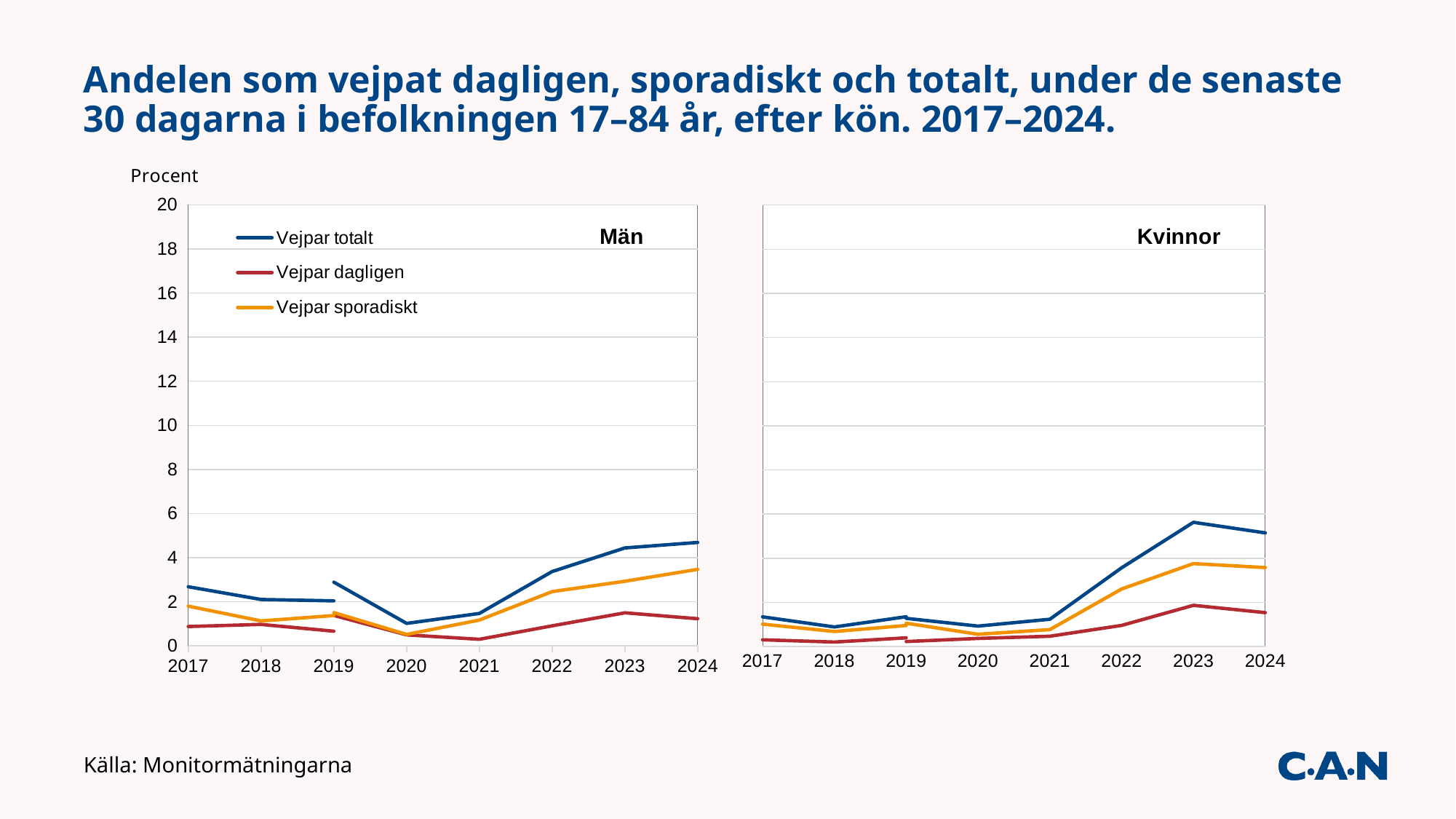
In the Kvinnor chart, is the value for Vejpar totalt in 2023 greater or less than 6? less How many series does the legend on the Män chart list? 3 Which is larger in 2023: Vejpar totalt in the Kvinnor chart or Vejpar totalt in the Män chart? Kvinnor What kind of chart is the Män chart? line chart In the Kvinnor chart, does Vejpar totalt rise or fall from 2021 to 2023? rise In the Män chart, is the value for Vejpar dagligen in 2023 greater or less than 2? less In the Män chart, is the value for Vejpar totalt in 2024 greater or less than 4? greater In the Kvinnor chart, which year has the highest value for Vejpar totalt? 2023 What is the label on the y axis of the charts? Procent In the Män chart, which year has the lowest value for Vejpar totalt? 2020 How many years are shown on the x axis of the Kvinnor chart? 8